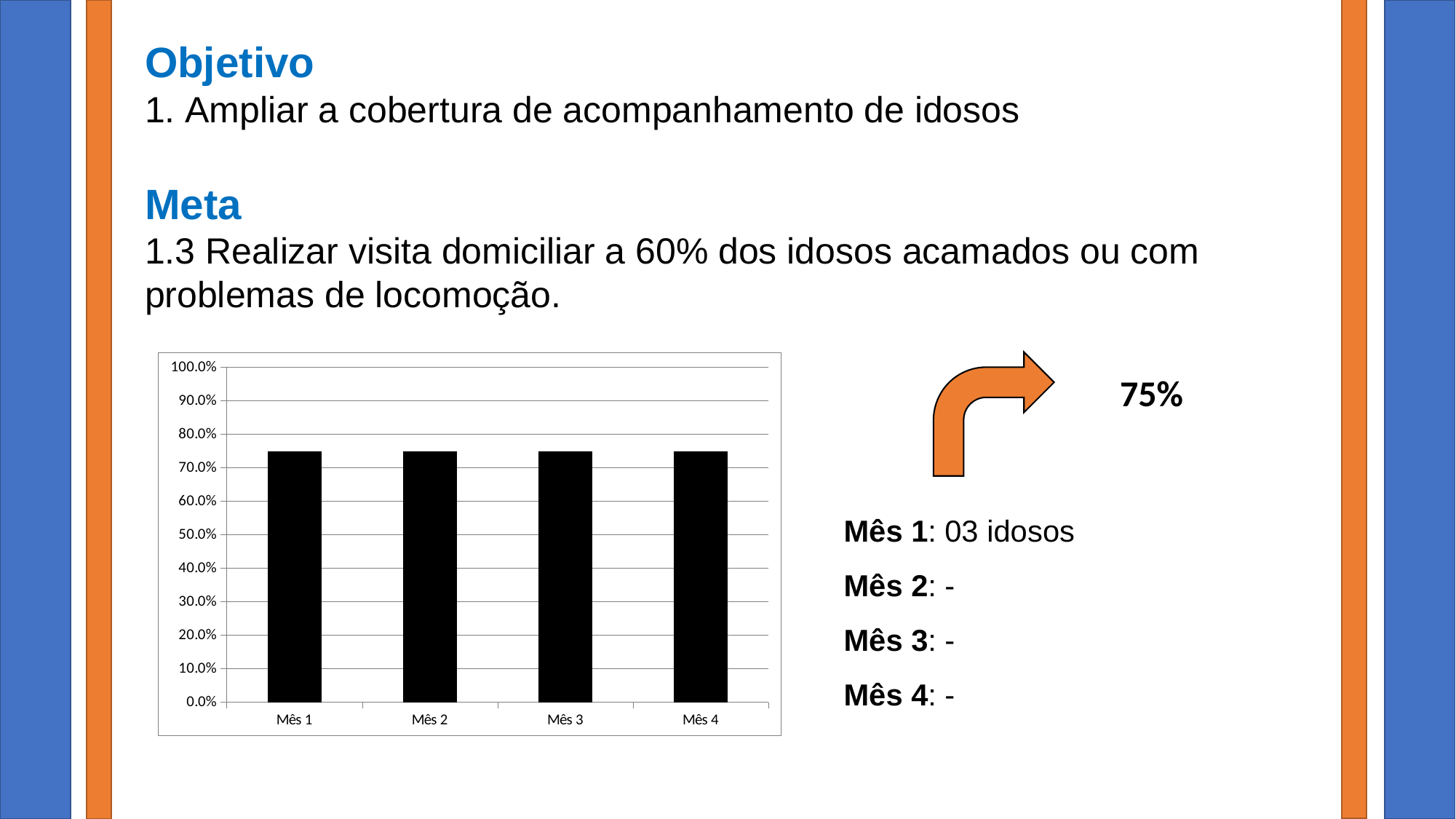
What kind of chart is shown on the slide? bar chart Is the value for Mês 3 greater or less than 60%? greater Is the value for Mês 2 greater or less than 80%? less What is the highest value shown on the y axis of the chart? 100.0% What is the label of the first category on the x axis? Mês 1 Is the value for Mês 4 greater or less than 90%? less Do the values rise, fall, or stay the same from Mês 1 to Mês 4? stay the same How many categories are shown on the x axis of the chart? 4